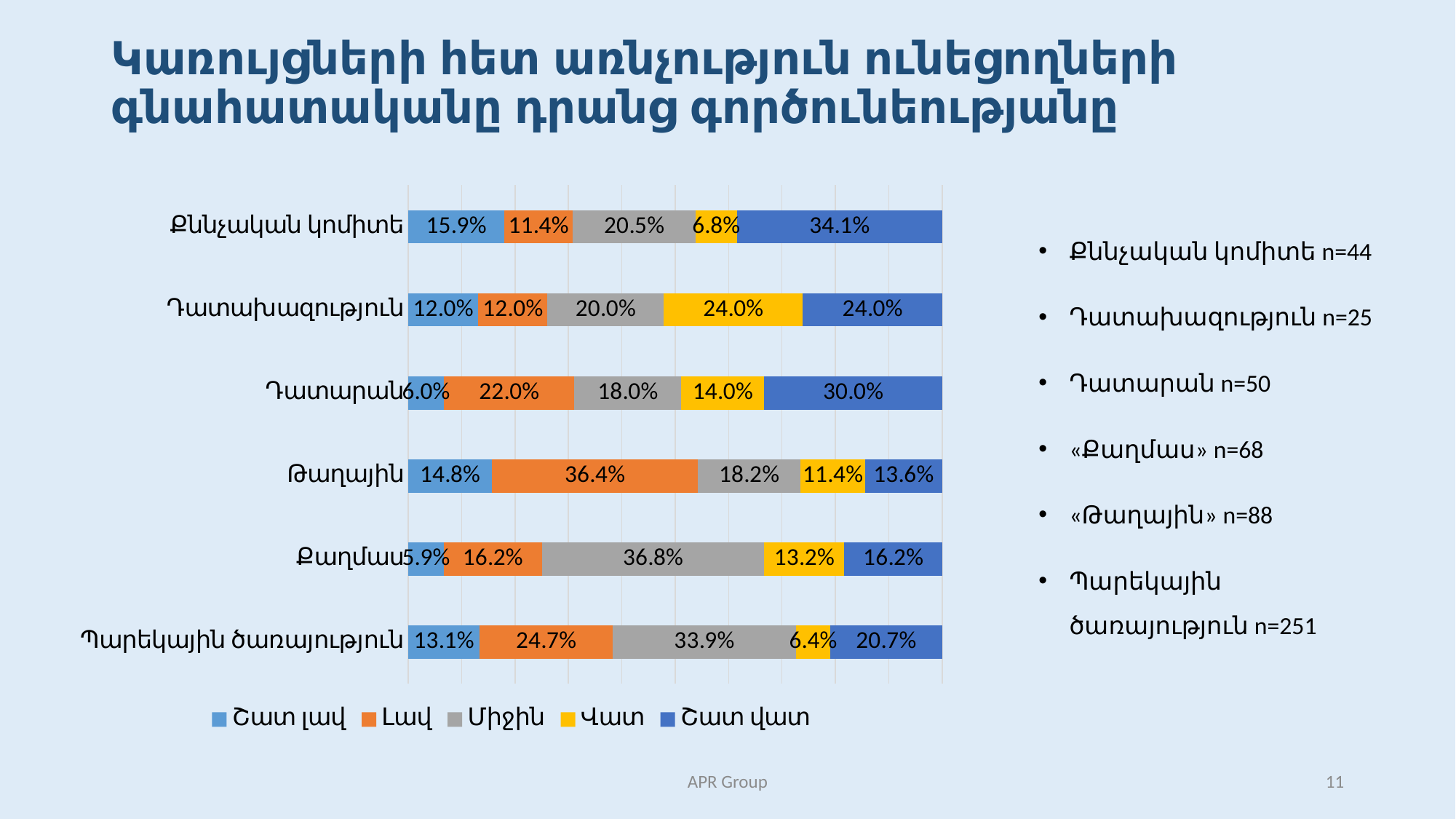
What is the value of the Լավ series for Թաղային? 36.4% Which series is shown in orange in the legend? Լավ Which category has the highest value in the Շատ վատ series? Քննչական կոմիտե Which is larger: the Լավ value for Պարեկային ծառայություն or the Լավ value for Դատարան? Պարեկային ծառայություն What is the difference between the Շատ վատ values for Դատարան and Թաղային? 16.4% Which category has the lowest value in the Շատ լավ series? Քաղմաս How many series does the legend list? 5 What is the value of the Շատ վատ series for Քննչական կոմիտե? 34.1% What kind of chart is shown on the slide? Stacked bar chart What is the value of the Միջին series for Քաղմաս? 36.8% How many categories are plotted on the chart? 6 What is the value of the Վատ series for Պարեկային ծառայություն? 6.4%